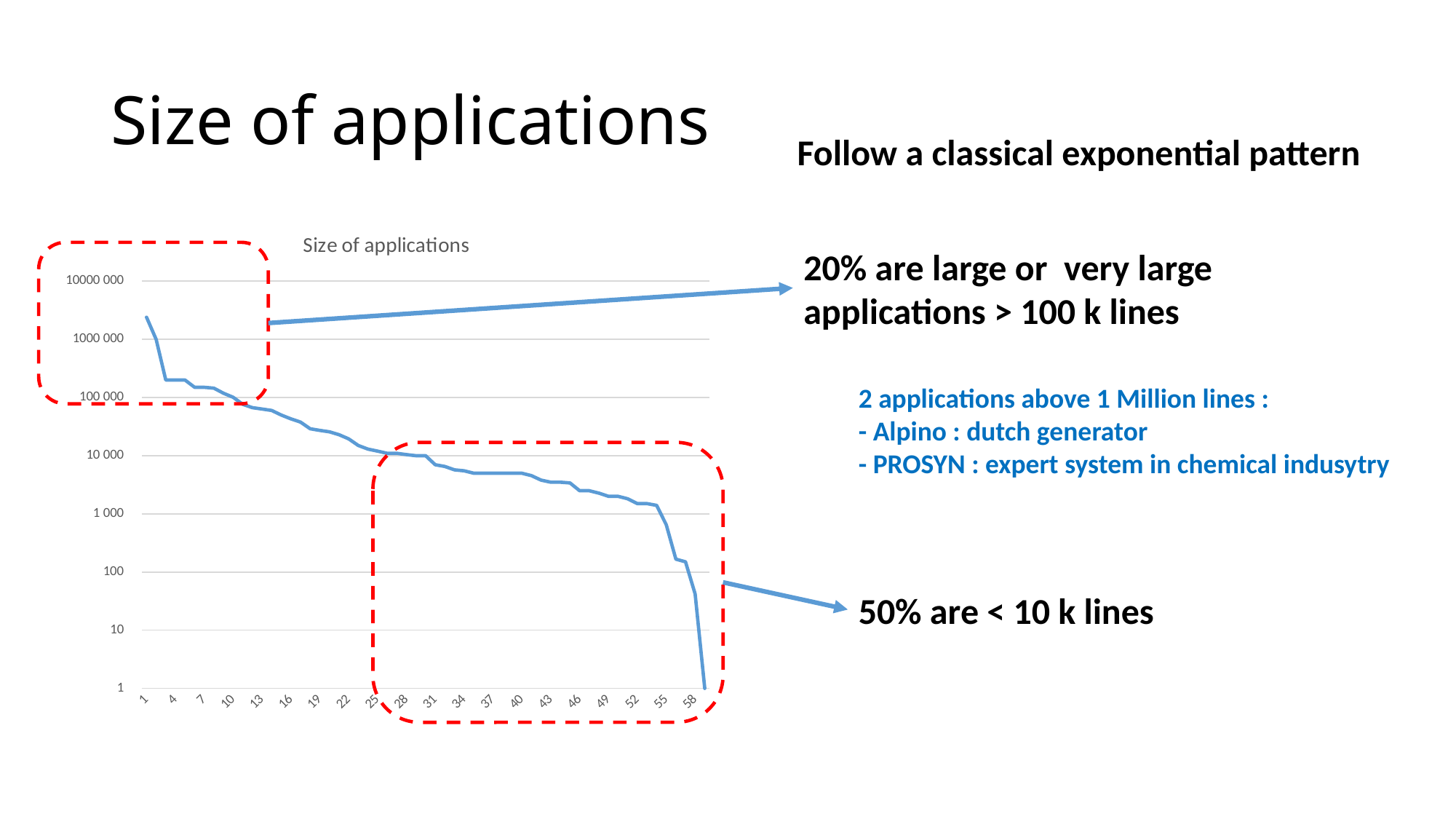
Which x-axis position has the highest value? 1 Is the value at x = 1 greater or less than 1000 000? greater What is the lowest tick label shown on the y axis? 1 Is the value at x = 28 greater or less than 1 000? greater Is the value at x = 52 greater or less than 1 000? greater What is the title of the chart? Size of applications What kind of chart is shown on the slide? line chart Which is larger, the value at x = 7 or the value at x = 46? x = 7 Do the values rise or fall as you move from left to right along the x axis? fall